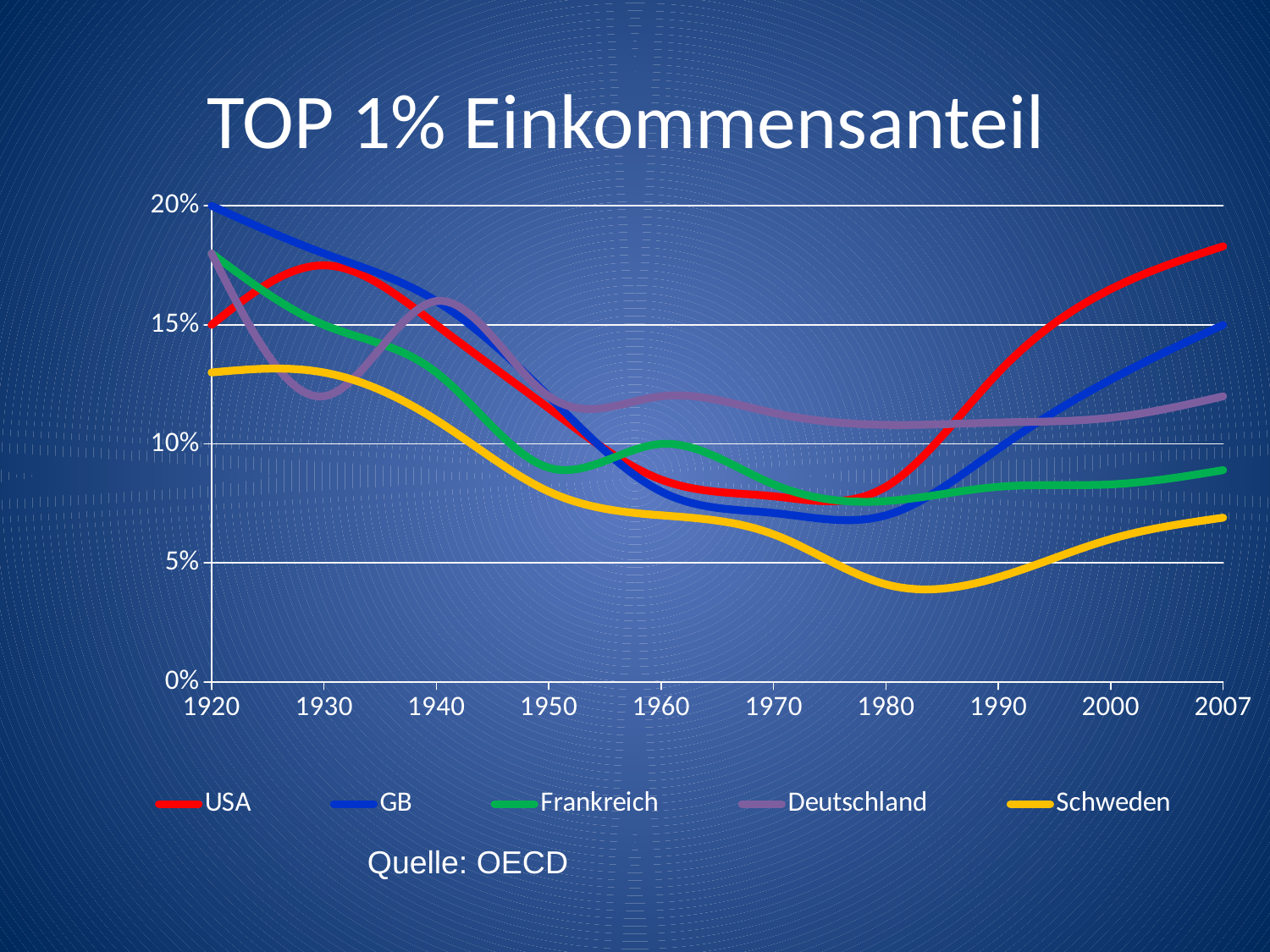
Which country has the highest value in 1920? GB Which colour is used for the Schweden line? yellow Which country has the highest value in 2007? USA Which is larger in 2007, the value for USA or the value for GB? USA Which country has the lowest value in 2007? Schweden Does the Schweden line rise or fall between 1920 and 1980? fall Which country has the lowest value in 1920? Schweden How many series does the legend list? 5 What is the title of the chart? TOP 1% Einkommensanteil What kind of chart is shown on the slide? line chart Is the value for USA in 2007 greater or less than 15%? greater Is the value for Schweden in 1980 greater or less than 5%? less